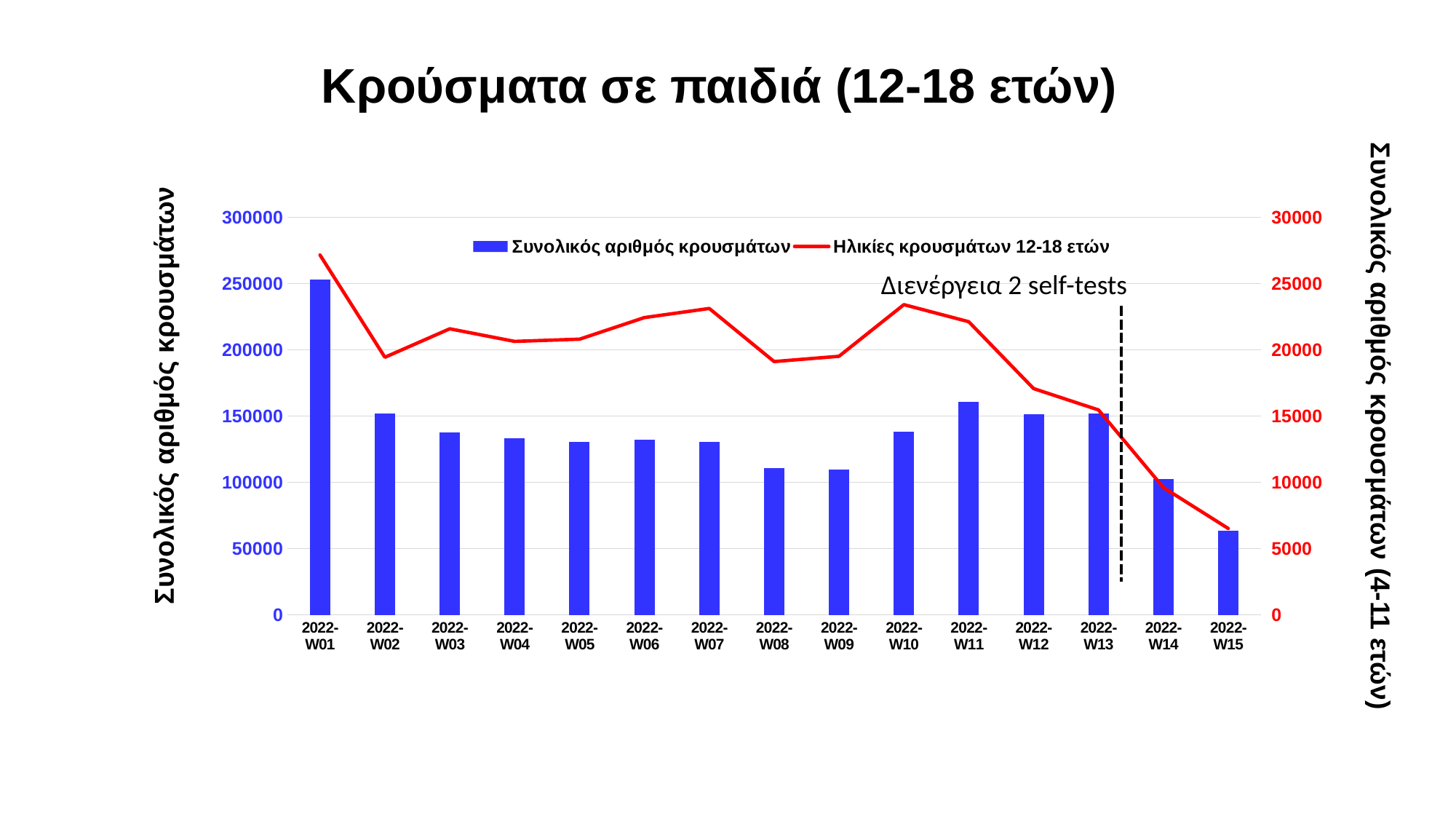
Is the bar for Συνολικός αριθμός κρουσμάτων in 2022-W01 greater or less than 200000? greater Which week has the lowest bar for Συνολικός αριθμός κρουσμάτων? 2022-W15 Is the value of the Ηλικίες κρουσμάτων 12-18 ετών line in 2022-W10 greater or less than 20000? greater Does the Ηλικίες κρουσμάτων 12-18 ετών line rise or fall from 2022-W13 to 2022-W15? fall What kind of chart is shown on the slide? A combined bar and line chart How many series does the chart legend list? 2 Is the bar for Συνολικός αριθμός κρουσμάτων in 2022-W15 greater or less than 100000? less How many weeks are shown on the x axis of the chart? 15 Which week has the highest bar for Συνολικός αριθμός κρουσμάτων? 2022-W01 Which week has the lowest value on the Ηλικίες κρουσμάτων 12-18 ετών line? 2022-W15 Which week has the highest value on the Ηλικίες κρουσμάτων 12-18 ετών line? 2022-W01 Which week has the larger bar for Συνολικός αριθμός κρουσμάτων, 2022-W11 or 2022-W09? 2022-W11